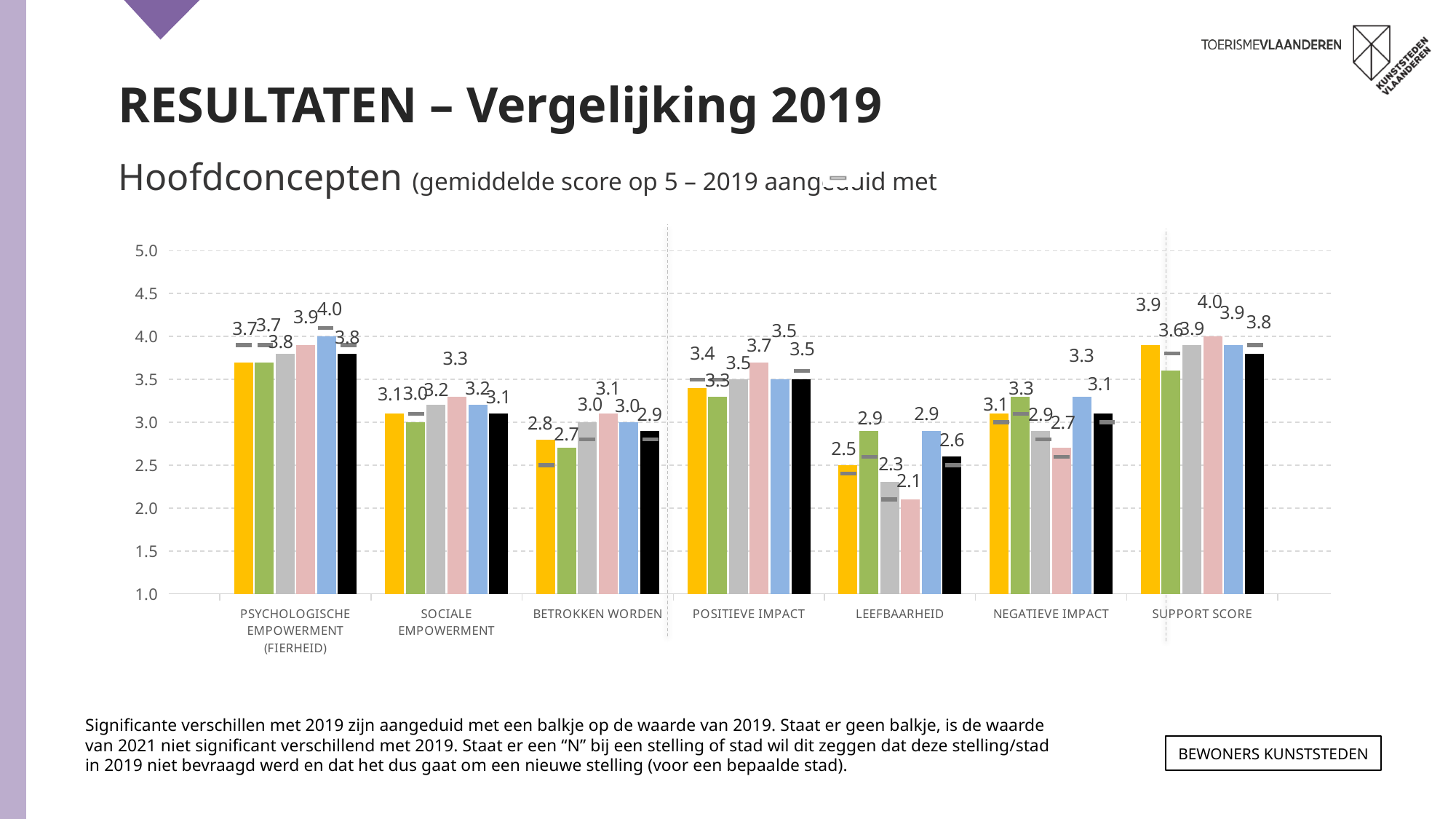
What is the highest value shown for Positieve impact? 3.7 What is the highest value shown for Psychologische empowerment (fierheid)? 4.0 How many categories are shown along the x axis of the chart? 7 Which category contains the lowest bar in the whole chart? Leefbaarheid What is the lowest value shown for Betrokken worden? 2.7 What is the lowest value shown for Sociale empowerment? 3.0 What is the maximum value shown on the y axis of the chart? 5.0 What is the difference between the highest and lowest values shown for Leefbaarheid? 0.8 How many bars are plotted for each category in the chart? 6 What type of chart is shown on the slide? bar chart Is the highest value for Leefbaarheid greater or less than 3.0? less